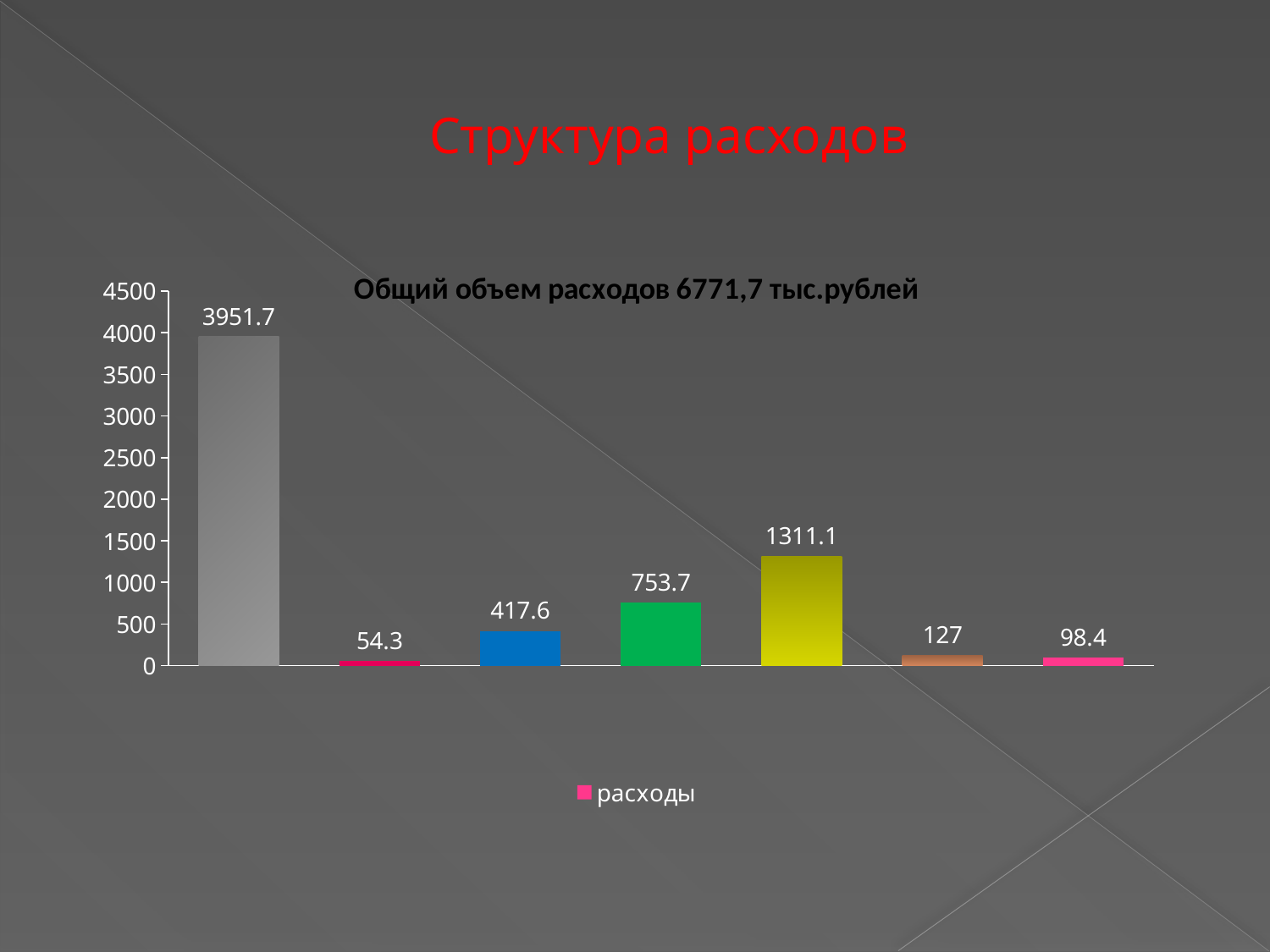
Which is larger: the brown bar (sixth from the left) or the pink bar (seventh from the left)? the brown bar (127) What is the value shown on the blue bar (third from the left)? 417.6 How many bars are plotted in the chart? 7 What is the value shown on the last (pink) bar on the right? 98.4 What type of chart is shown on the slide? bar chart What is the value shown on the yellow bar (fifth from the left)? 1311.1 How many series does the legend list? 1 Which bar has the highest value in the chart? the first (grey) bar, 3951.7 What is the value shown on the first (grey) bar of the chart? 3951.7 Which bar has the lowest value in the chart? the second (red) bar, 54.3 What is the title of the chart? Общий объем расходов 6771,7 тыс.рублей What is the difference between the green bar (753.7) and the blue bar (417.6)? 336.1